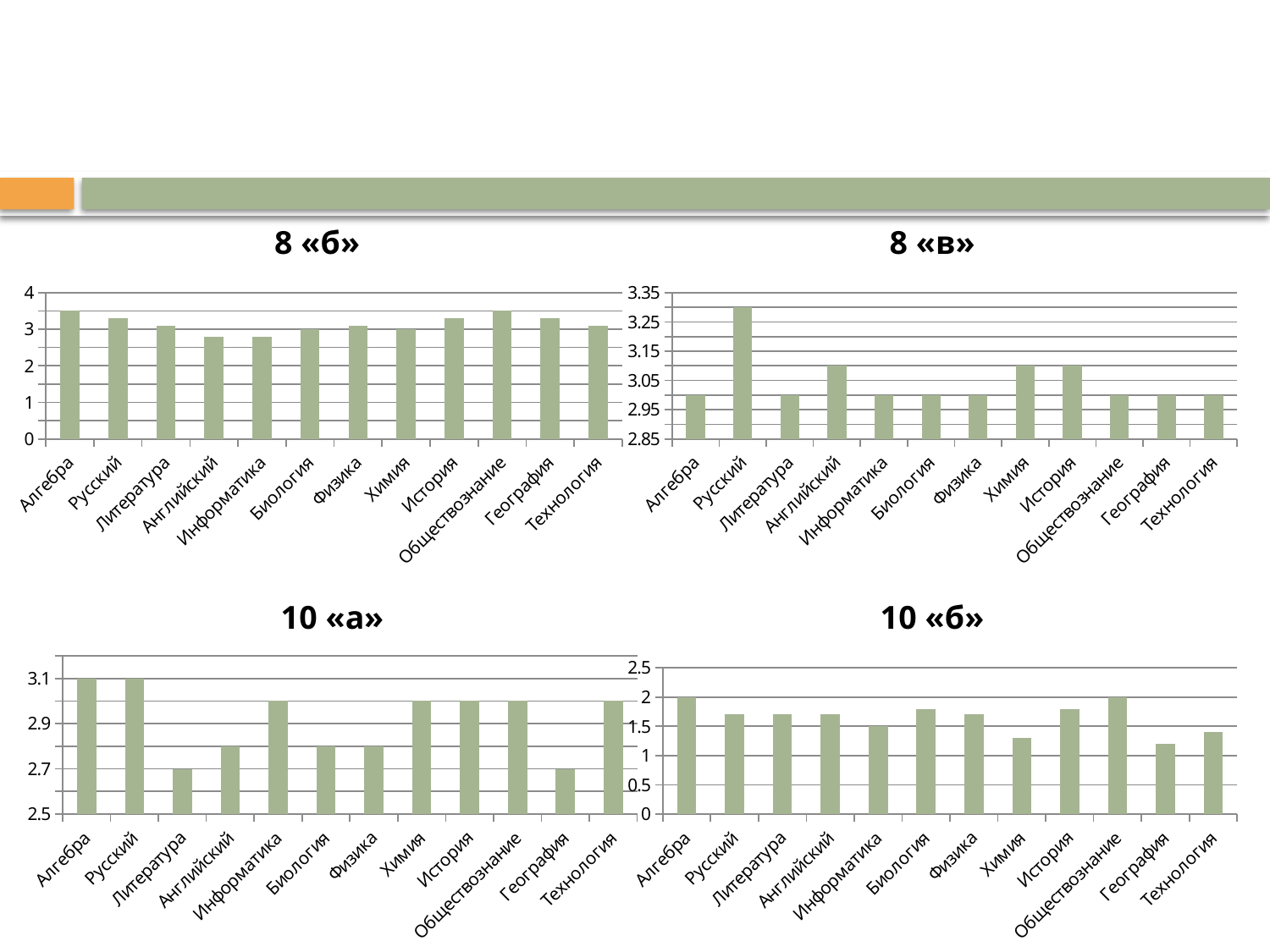
In the 10 «а» chart, what is the value for Алгебра? 3.1 In the 8 «в» chart, which is larger, the value for Английский or the value for Литература? Английский In the 10 «б» chart, is the value for География greater or less than 1.5? less In the 8 «б» chart, which is larger, the value for Алгебра or the value for Английский? Алгебра In the 10 «б» chart, what is the value for Информатика? 1.5 In the 8 «в» chart, which subject has the highest value? Русский How many charts are shown on the slide? 4 In the 8 «в» chart, is the value for Русский greater or less than 3.25? greater In the 8 «б» chart, is the value for Алгебра greater or less than 3? greater In the 10 «а» chart, what is the value for Литература? 2.7 How many subject categories are shown on the x axis of the 8 «в» chart? 12 What kind of chart is the 8 «б» chart? bar chart